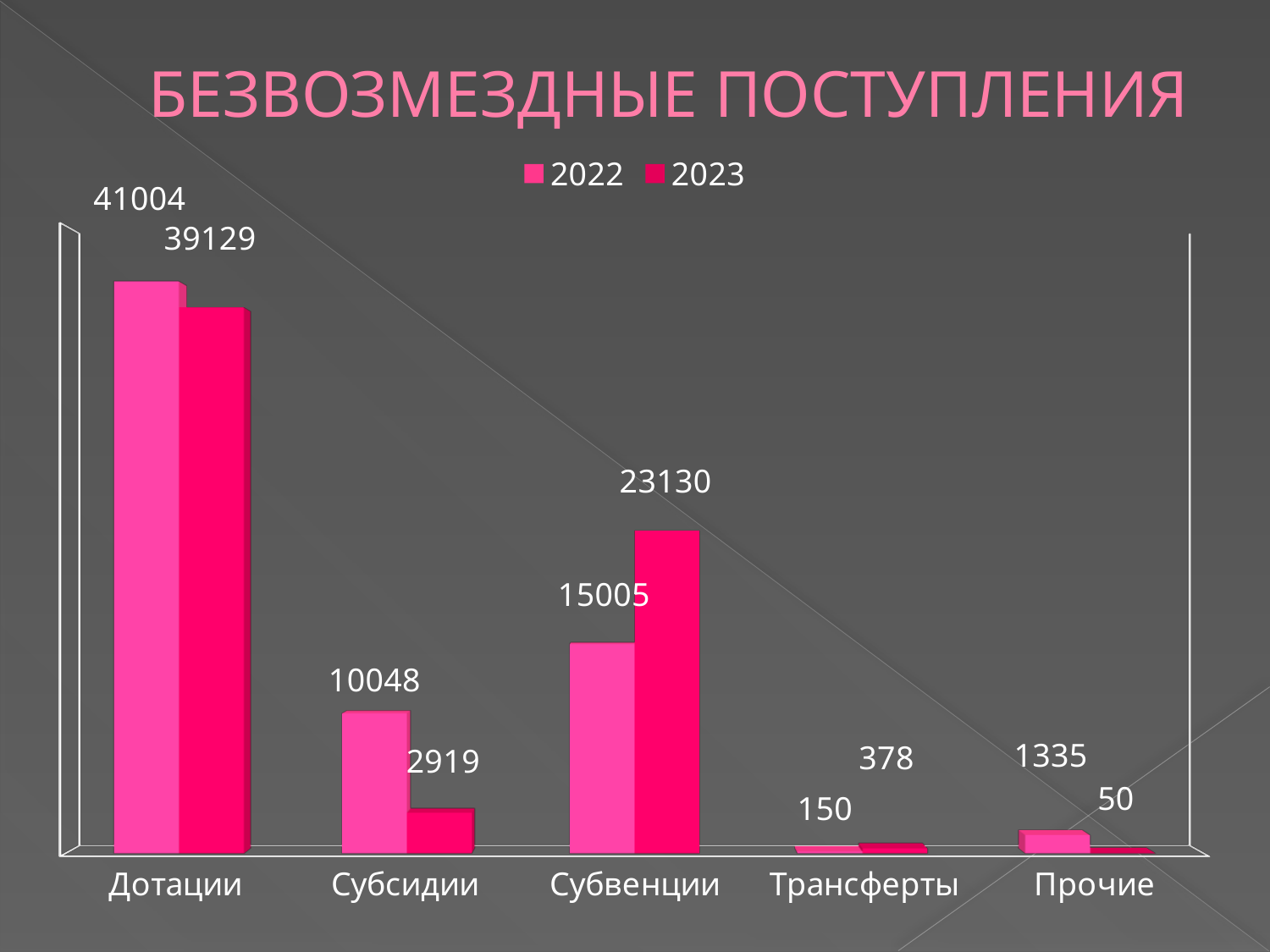
How many categories are shown on the x axis? 5 What is the value for Субсидии in the 2023 series? 2919 What is the value for Дотации in the 2022 series? 41004 How many series does the legend list? 2 What kind of chart is shown on the slide? Bar chart Which category has the highest value in the 2023 series? Дотации What is the value for Прочие in the 2022 series? 1335 Which is larger for Субсидии: the 2022 value or the 2023 value? 2022 What is the difference between the 2022 and 2023 values for Дотации? 1875 What is the value for Субвенции in the 2023 series? 23130 What is the difference between the 2022 and 2023 values for Субвенции? 8125 Which category has the lowest value in the 2023 series? Прочие